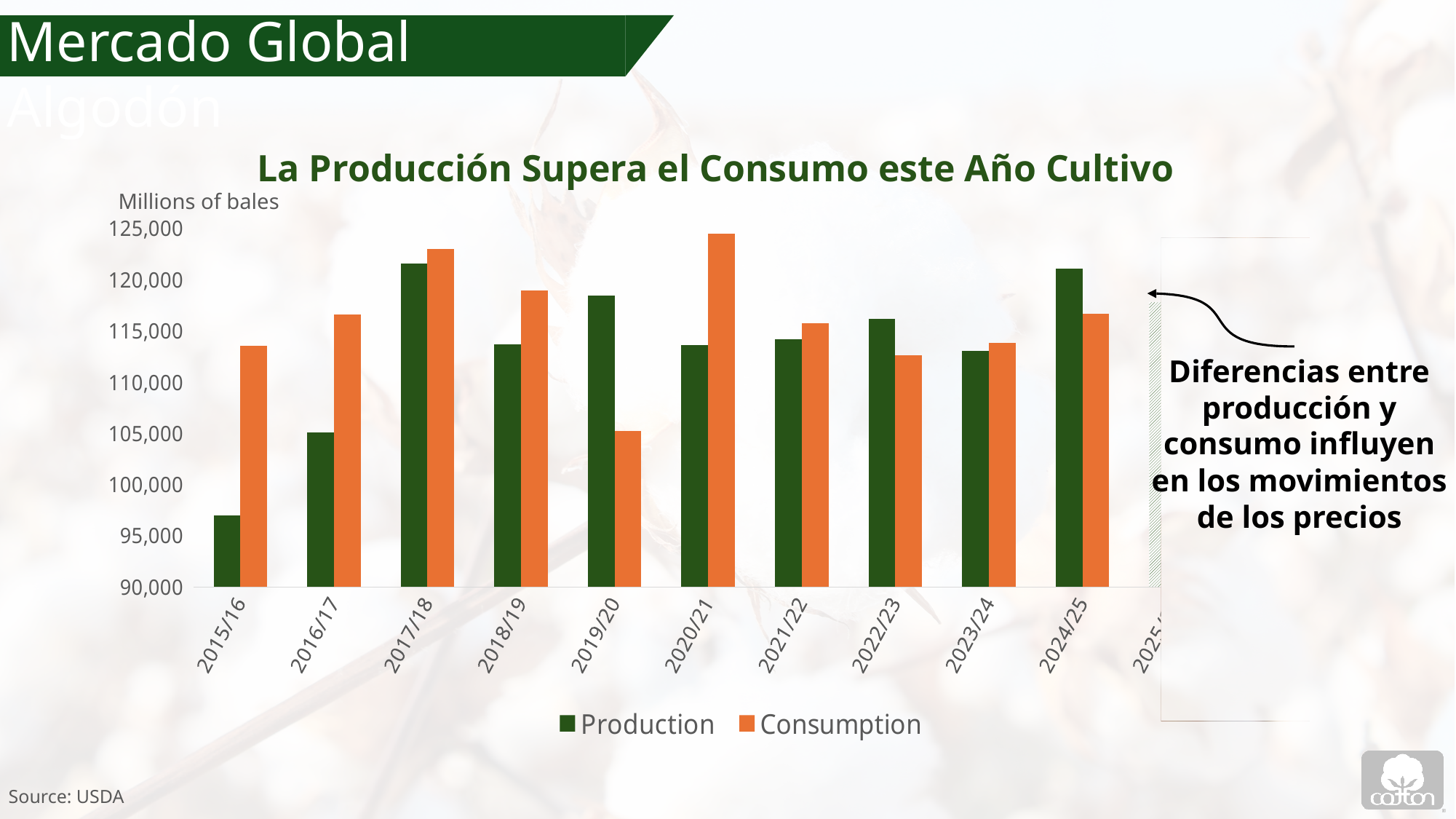
Which year has the lowest Production value? 2015/16 What kind of chart is shown on the slide? bar chart Which year has the lowest Consumption value? 2019/20 What unit is shown on the vertical axis of the chart? Millions of bales How many series does the legend list? 2 Which year has the highest Consumption value? 2020/21 Is the Consumption value for 2019/20 greater or less than 110,000? less In 2020/21, which is larger, Production or Consumption? Consumption In 2019/20, which is larger, Production or Consumption? Production Is the Production value for 2015/16 greater or less than 100,000? less Is the Production value for 2024/25 greater or less than 120,000? greater